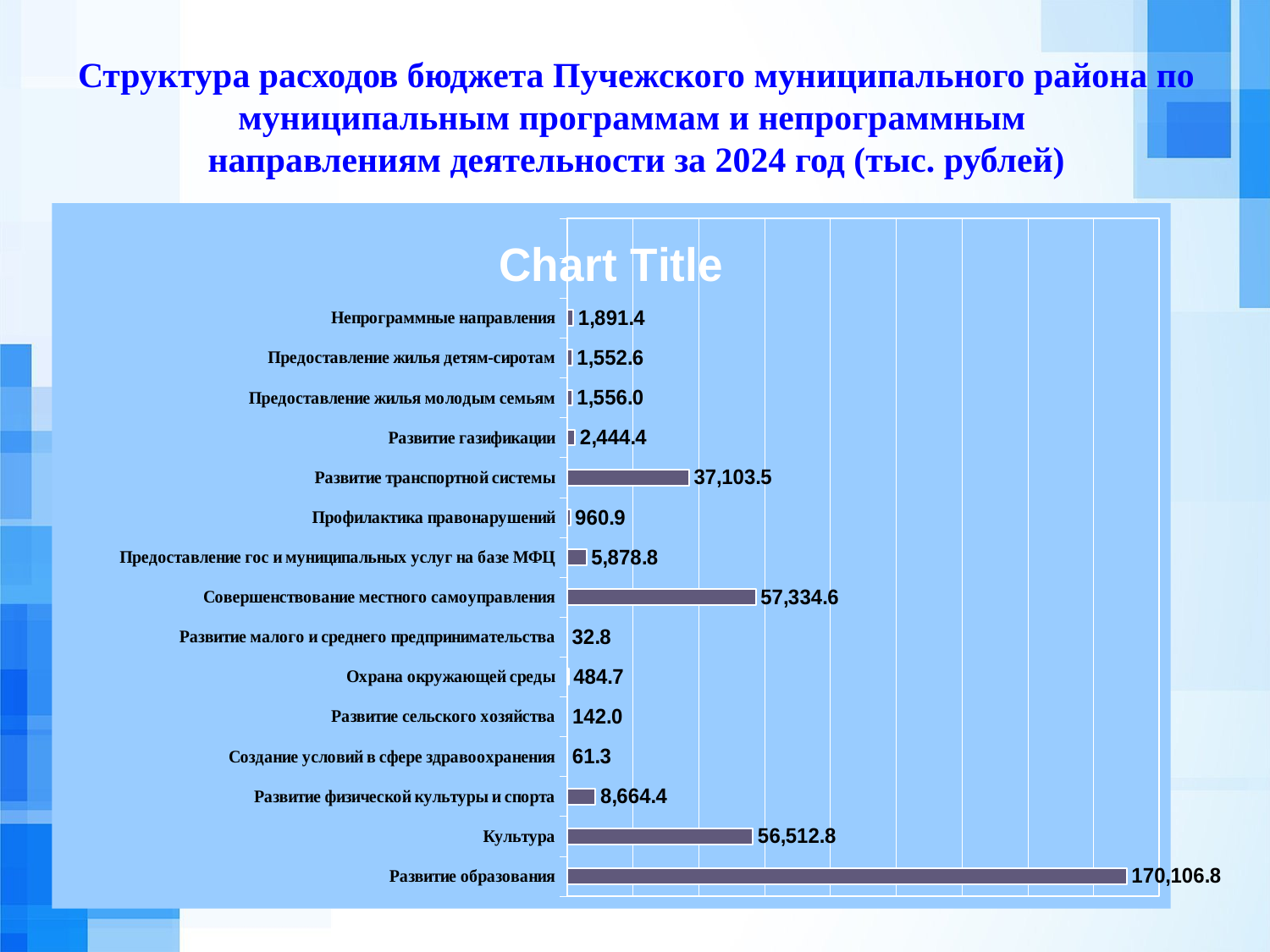
What is the value for Развитие транспортной системы? 37,103.5 How many categories are shown in the chart? 15 What title is printed inside the chart area? Chart Title Which is larger, the value for Совершенствование местного самоуправления or the value for Культура? Совершенствование местного самоуправления What is the value for Культура? 56,512.8 Which category has the highest value? Развитие образования What is the difference between the values for Развитие транспортной системы and Развитие физической культуры и спорта? 28,439.1 What is the value for Предоставление гос и муниципальных услуг на базе МФЦ? 5,878.8 What is the difference between the values for Развитие образования and Культура? 113,594.0 What is the value for Развитие образования? 170,106.8 Which category has the lowest value? Развитие малого и среднего предпринимательства What kind of chart is shown on the slide? Bar chart